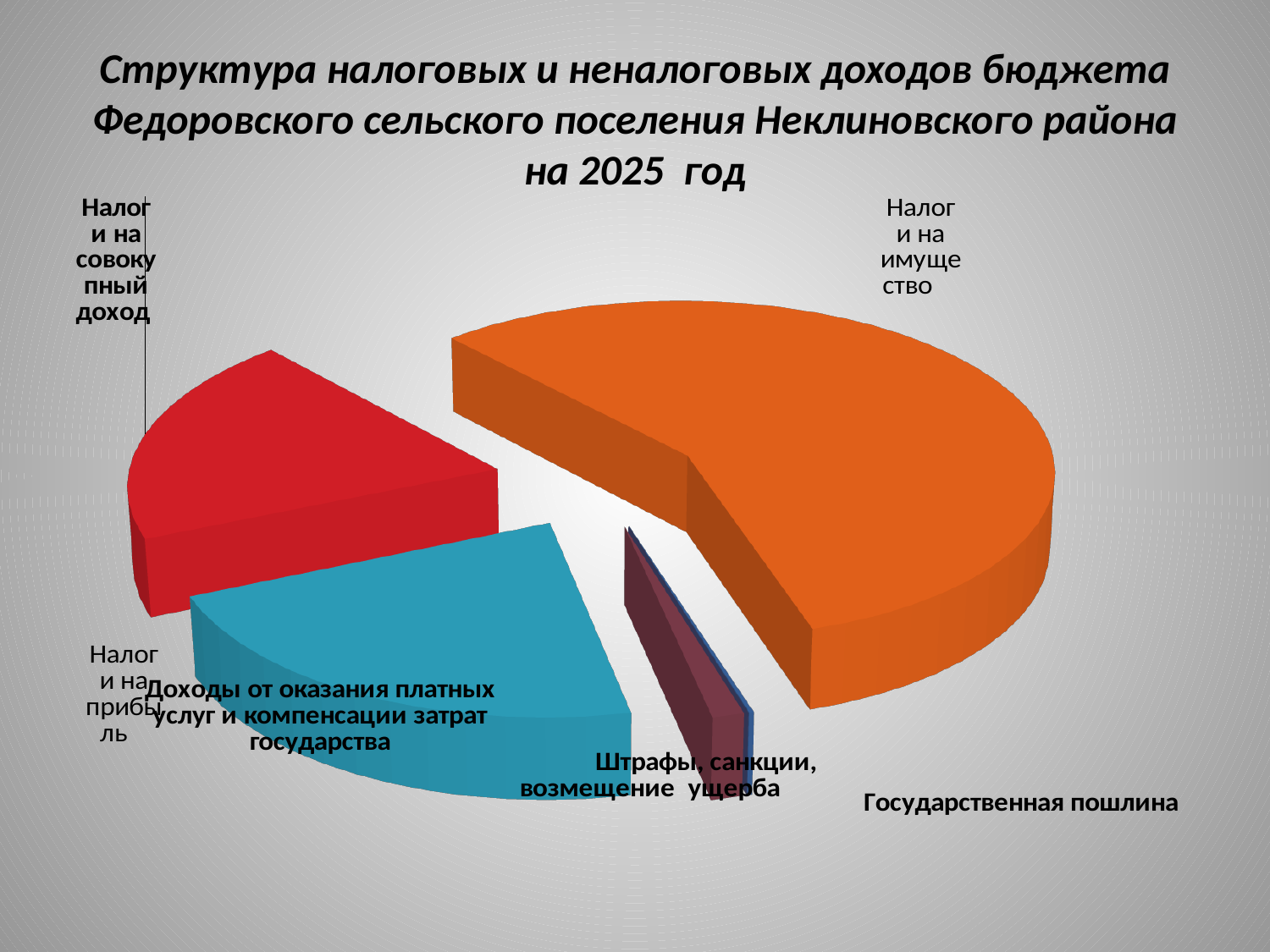
Which category has the largest slice of the pie? Налоги на имущество Which is larger: the slice for Налоги на имущество or the slice for Доходы от оказания платных услуг и компенсации затрат государства? Налоги на имущество Which is larger: the slice for Налоги на имущество or the slice for Налоги на совокупный доход? Налоги на имущество What year does the chart title refer to? 2025 What colour is the largest slice of the pie? orange How many categories are labeled on the pie chart? 6 Which is larger: the slice for Доходы от оказания платных услуг и компенсации затрат государства or the slice for Штрафы, санкции, возмещение ущерба? Доходы от оказания платных услуг и компенсации затрат государства What kind of chart is shown on the slide? pie chart